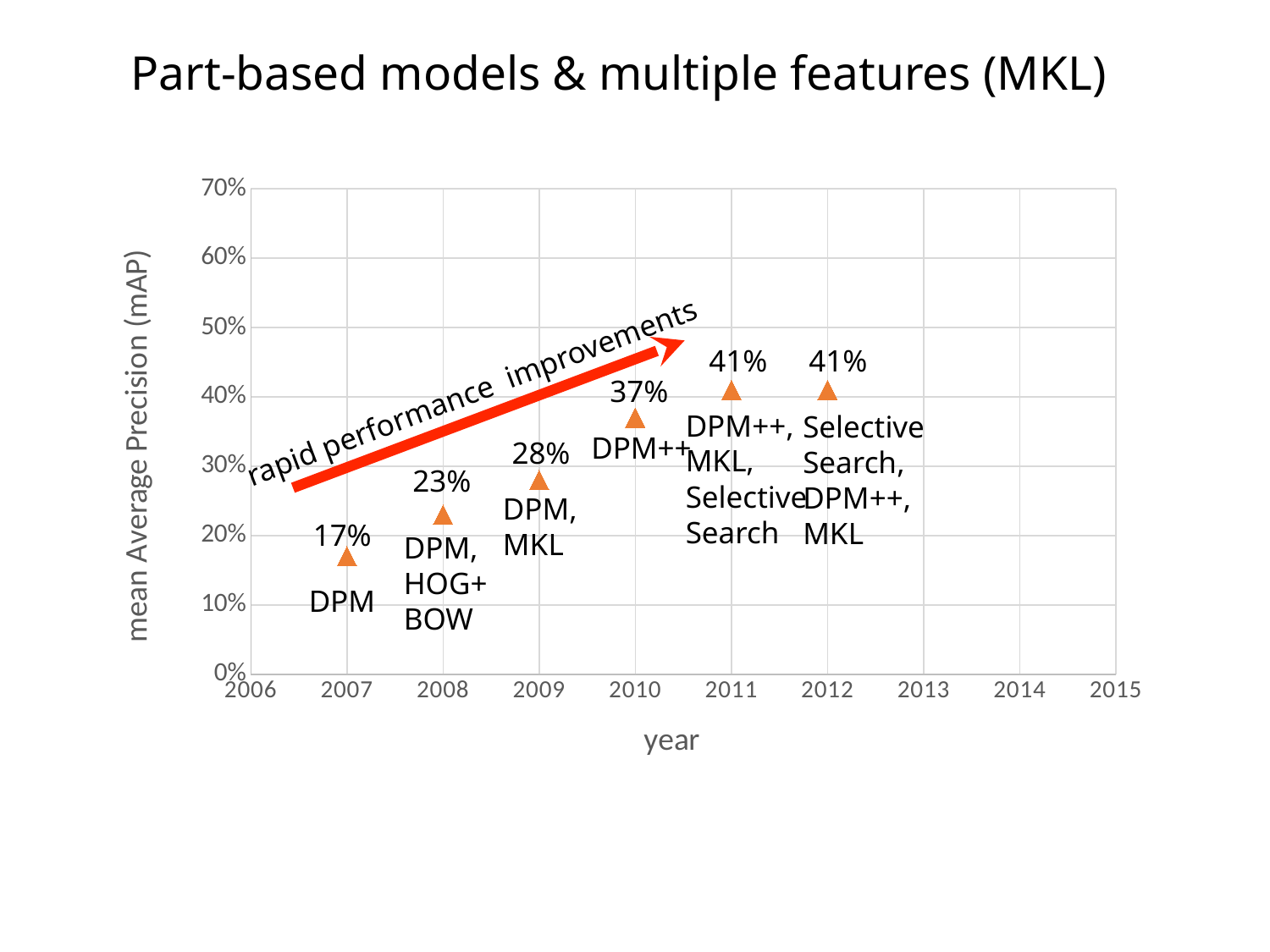
What is the difference in mAP between 2011 and 2007? 24% What is the mAP value plotted for 2009? 28% What is the difference in mAP between 2010 and 2008? 14% What is the label on the x axis of the chart? year What is the mAP value plotted for 2010? 37% What is the mean Average Precision (mAP) value plotted for 2007? 17% Which is larger, the mAP value for 2009 or for 2010? 2010 What is the mAP value plotted for 2012? 41% How many data points are plotted on the chart? 6 Is the mAP value for 2008 greater or less than 30%? less Do the plotted mAP values rise or fall from 2007 to 2012? rise Which year has the lowest plotted mAP value? 2007